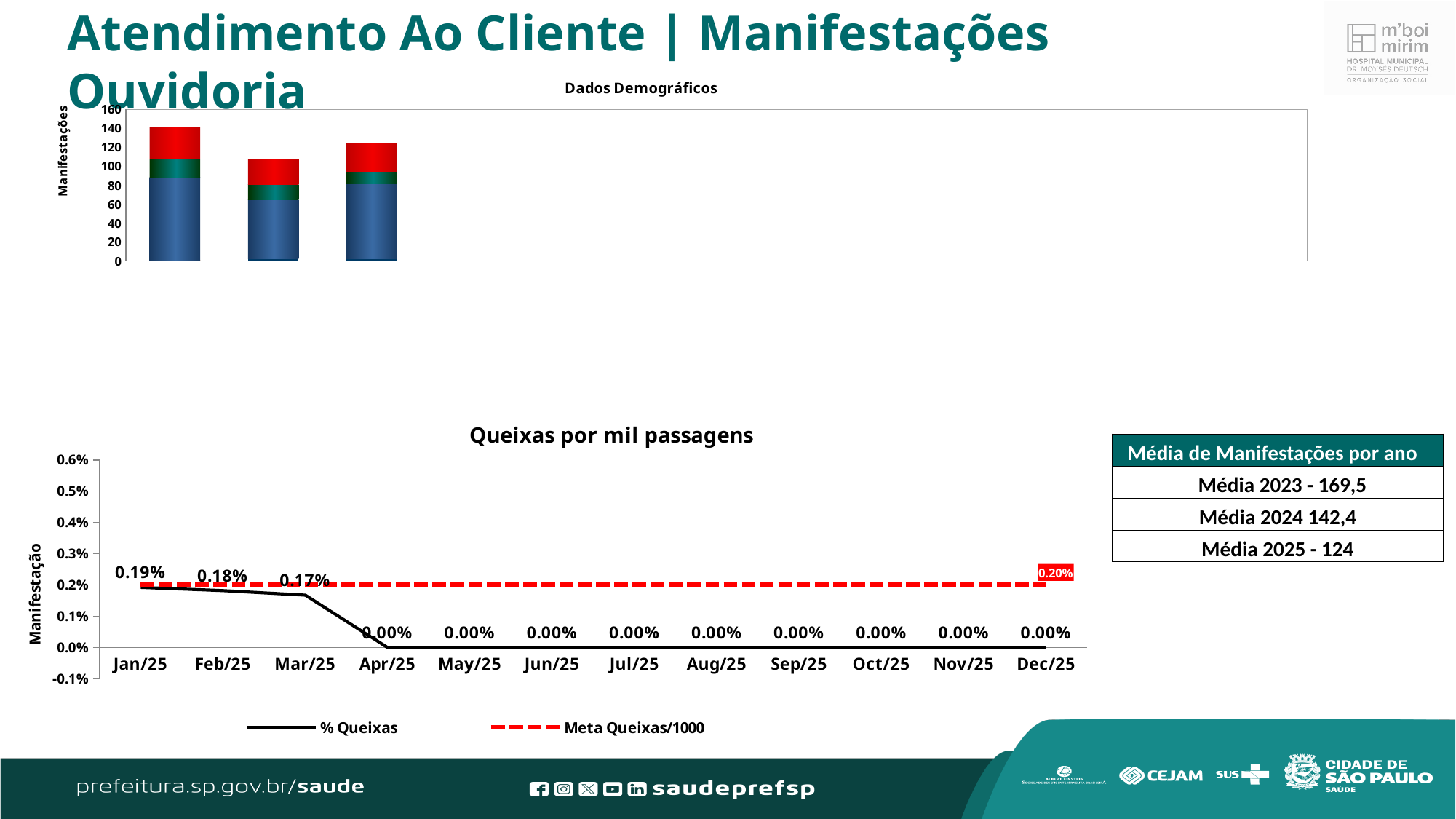
In the 'Queixas por mil passagens' chart, what is the % Queixas value for Feb/25? 0.18% In the 'Queixas por mil passagens' chart, how many series does the legend list? 2 In the 'Queixas por mil passagens' chart, how many months are shown on the x axis? 12 In the 'Queixas por mil passagens' chart, what is the difference between the % Queixas values for Jan/25 and Mar/25? 0.02% In the 'Queixas por mil passagens' chart, what is the value of the Meta Queixas/1000 line? 0.20% In the 'Queixas por mil passagens' chart, what is the % Queixas value for Jan/25? 0.19% In the 'Queixas por mil passagens' chart, what is the % Queixas value for Mar/25? 0.17% In the 'Queixas por mil passagens' chart, what is the % Queixas value for Jul/25? 0.00% In the 'Queixas por mil passagens' chart, which month has the highest % Queixas value? Jan/25 In the 'Queixas por mil passagens' chart, is the % Queixas value for Feb/25 larger or smaller than the Meta Queixas/1000 value? smaller In the 'Queixas por mil passagens' chart, does the % Queixas line rise or fall from Jan/25 to Apr/25? fall What kind of chart is the 'Dados Demográficos' chart at the top of the slide? bar chart